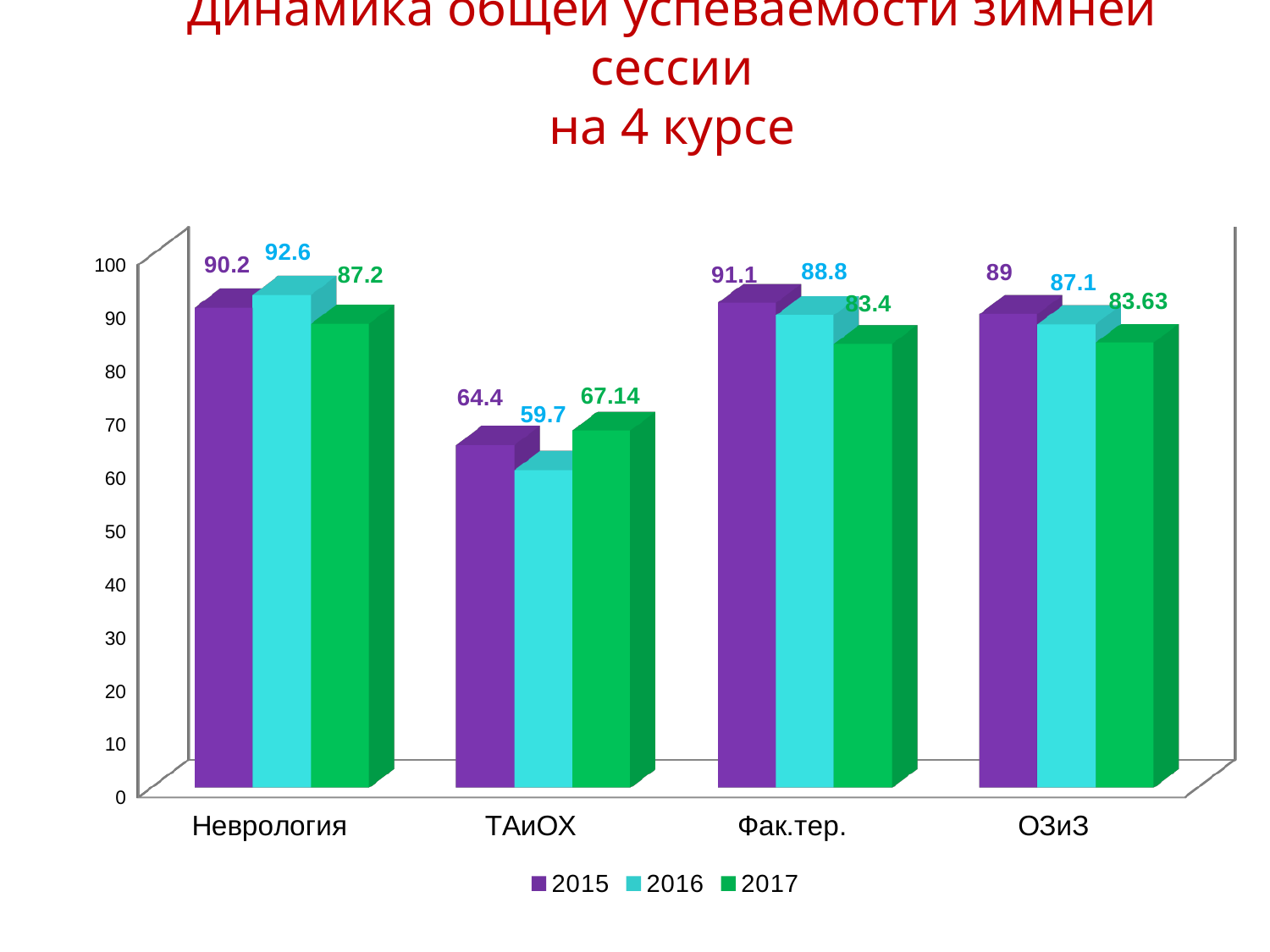
Which category has the highest value in 2015? Фак.тер. What is the difference between the 2015 and 2016 values for ТАиОХ? 4.7 Which is larger for Фак.тер.: the 2015 value or the 2017 value? 2015 Do the values for ОЗиЗ rise or fall from 2015 to 2017? fall What is the value for ОЗиЗ in 2015? 89 What is the value for ТАиОХ in 2017? 67.14 What kind of chart is shown on the slide? bar chart How many series does the legend list? 3 Which category has the lowest value in 2016? ТАиОХ How many categories are shown on the x axis? 4 Which colour represents the 2017 series in the legend? green What is the value for Неврология in 2016? 92.6